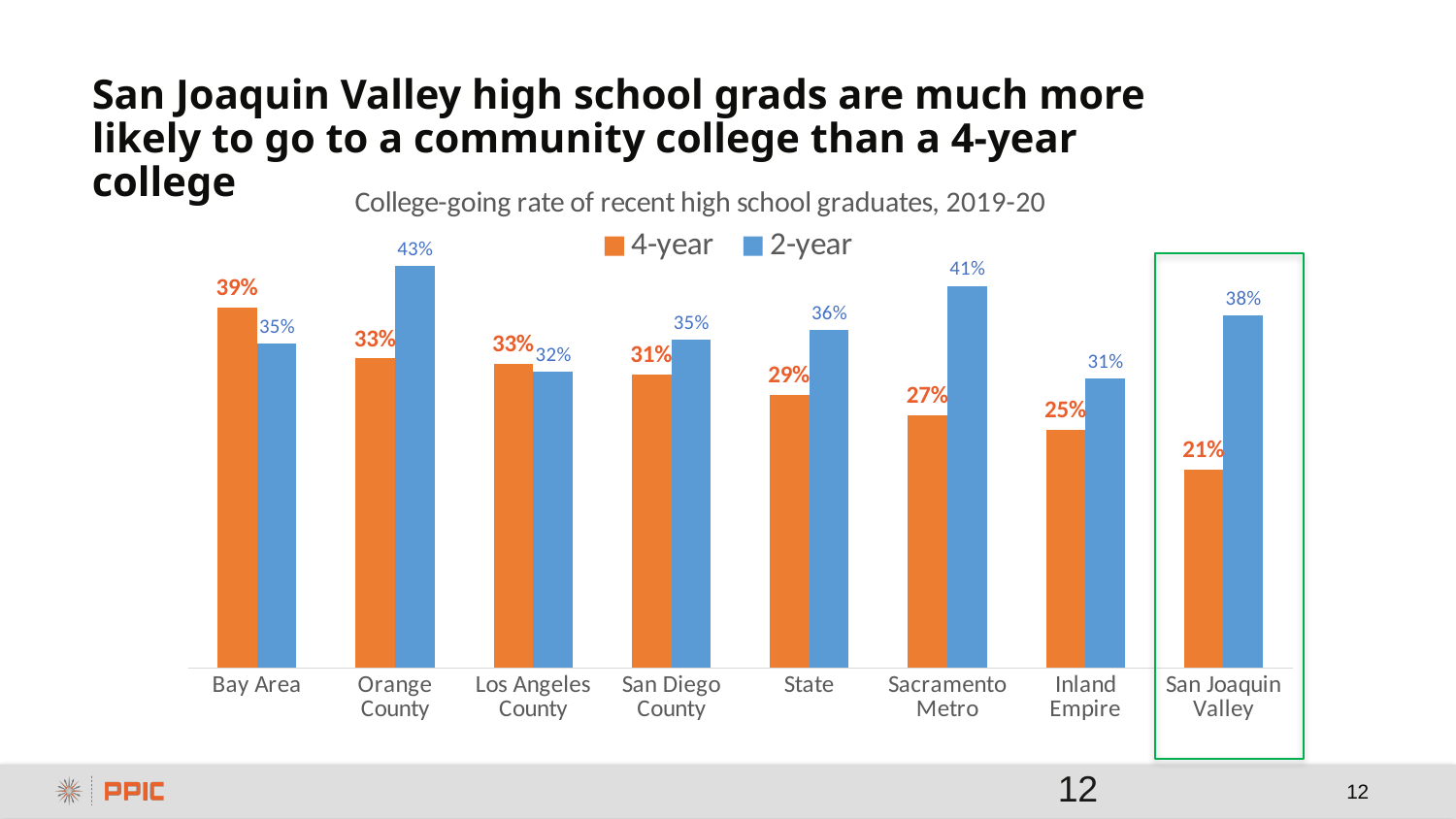
How many regions are shown on the x axis? 8 Which region has the highest 4-year college-going rate? Bay Area What kind of chart is shown on the slide? Bar chart What is the 2-year college-going rate for Sacramento Metro? 41% What is the 4-year college-going rate for the State? 29% Which colour represents the 2-year series? Blue What is the difference between the 2-year and 4-year rates for San Joaquin Valley? 17 percentage points Which is larger for Orange County: the 4-year rate or the 2-year rate? 2-year rate What is the title of the chart? College-going rate of recent high school graduates, 2019-20 How many series does the legend list? 2 What is the 4-year college-going rate for San Joaquin Valley? 21% Which region has the lowest 2-year college-going rate? Inland Empire